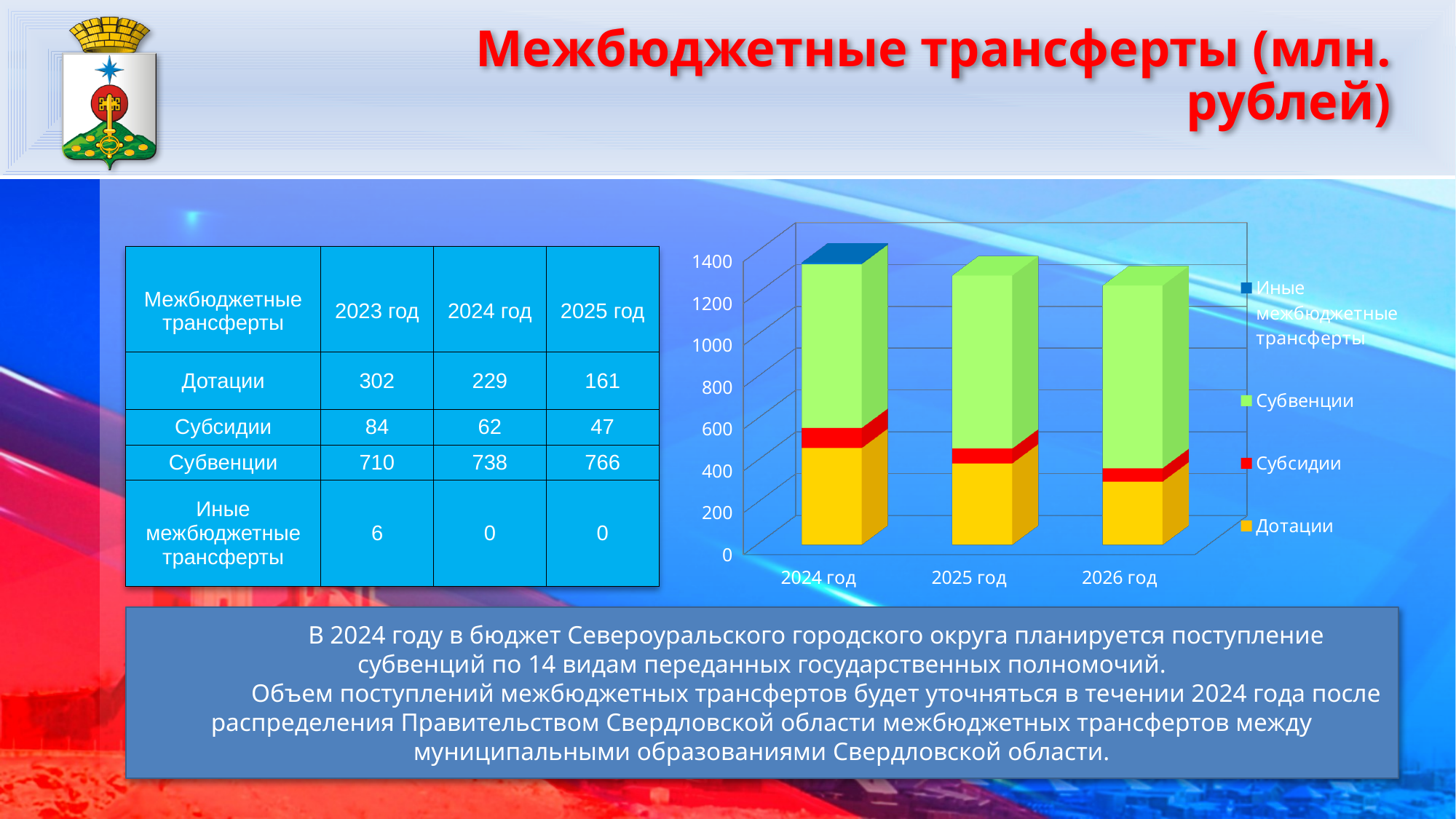
Which series in the chart is drawn in green? Субвенции What kind of chart is shown on the slide? stacked bar chart How many year categories are shown on the x axis of the chart? 3 Which year has the tallest stacked bar in the chart? 2024 год Is the Субсидии segment for 2026 год greater or less than 200? less Which series is shown at the bottom of each stacked bar in the chart? Дотации Is the total height of the stacked bar for 2026 год greater or less than 1000? greater Is the total height of the stacked bar for 2024 год greater or less than 1200? greater How many series does the chart legend list? 4 Does the Дотации segment rise or fall from 2024 год to 2026 год? fall In the 2024 год bar, which segment is larger: Субвенции or Субсидии? Субвенции